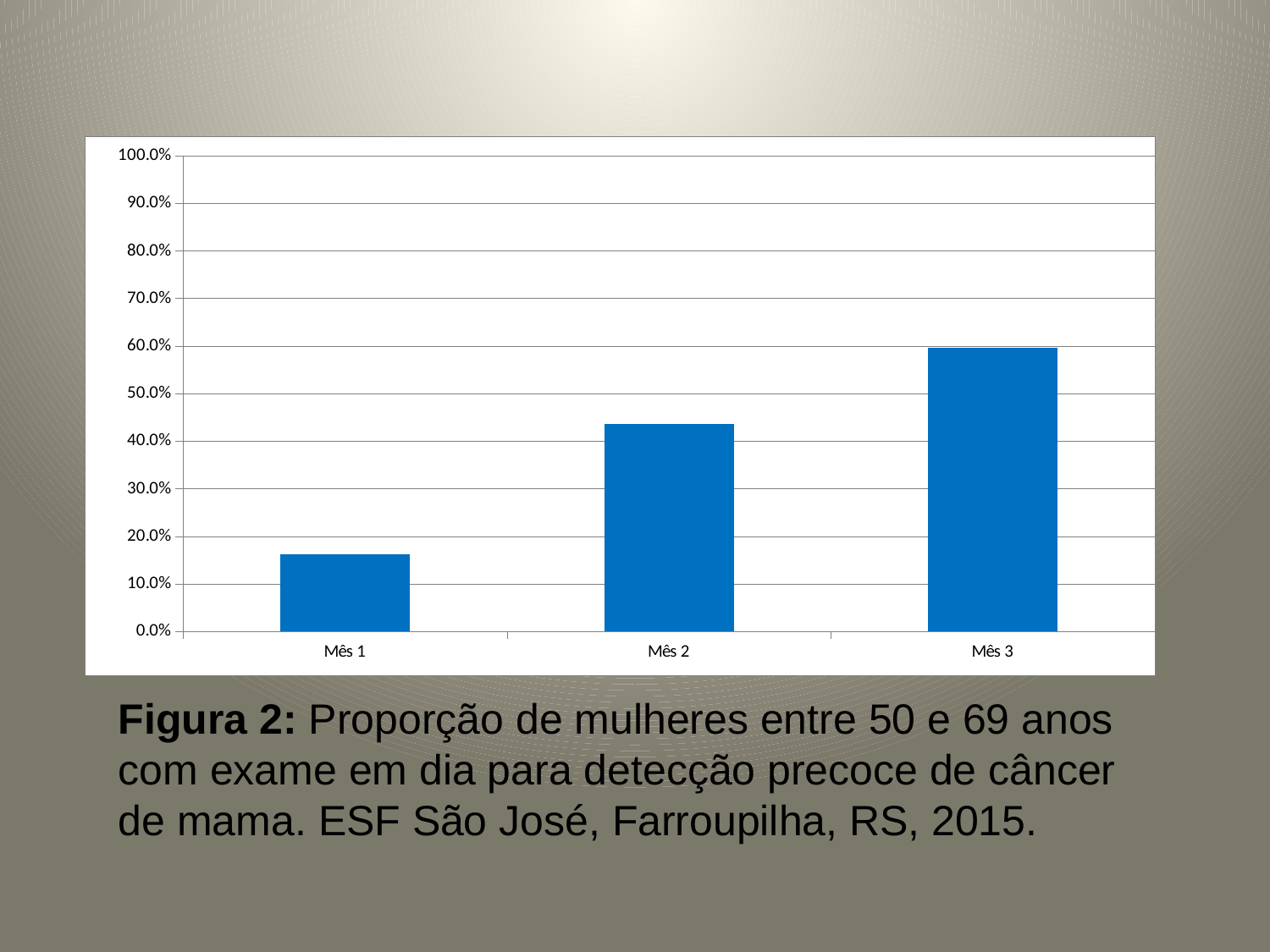
Which is larger, the value for Mês 1 or the value for Mês 2? Mês 2 How many categories (bars) does the chart show? 3 Which month has the highest value? Mês 3 Which month has the lowest value? Mês 1 Is the value for Mês 1 greater or less than 10.0%? greater Is the value for Mês 2 greater or less than 40.0%? greater Is the value for Mês 2 greater or less than 50.0%? less What kind of chart is shown on the slide? bar chart Do the values rise or fall from Mês 1 to Mês 3? rise